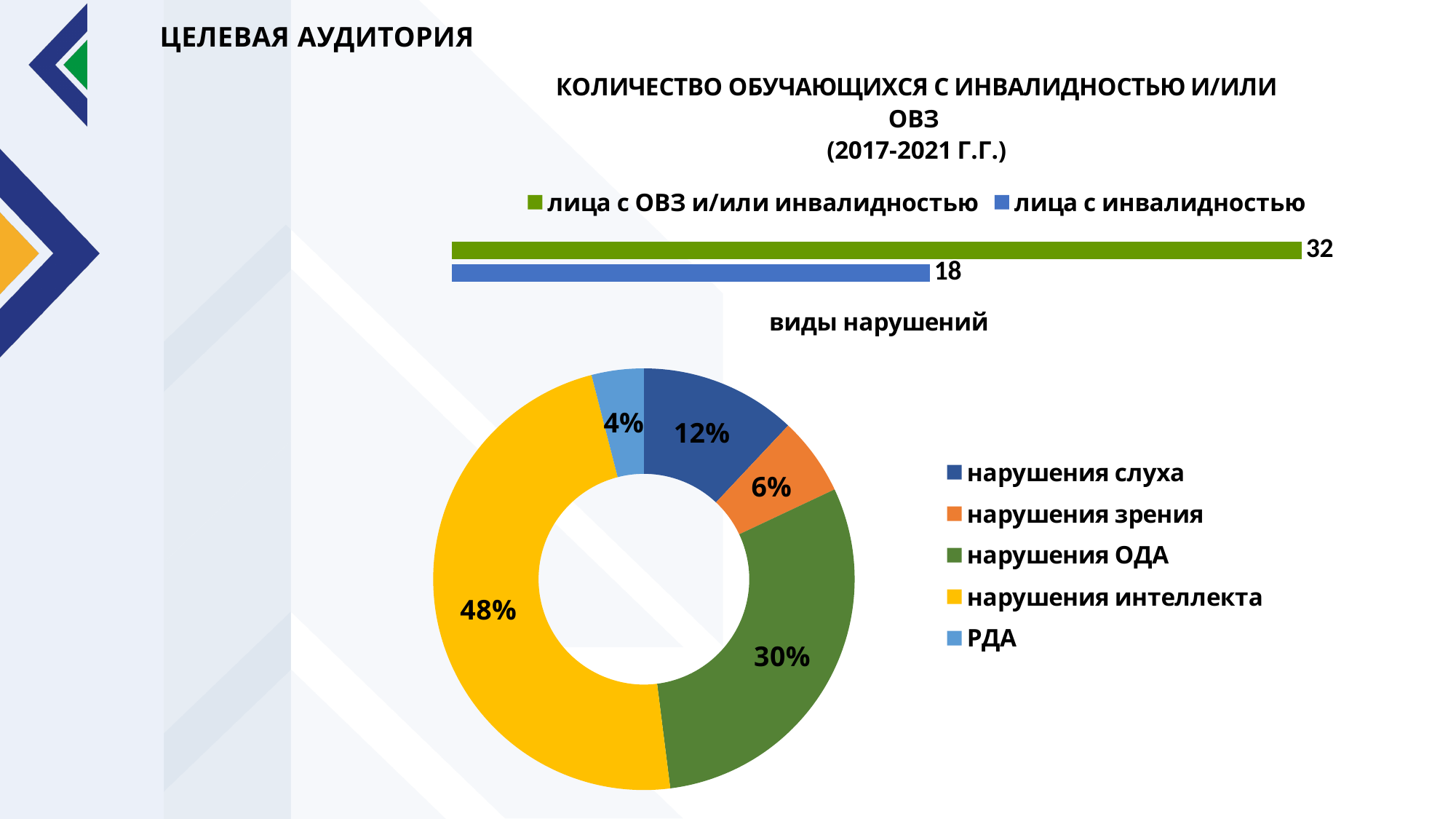
How many categories does the chart titled "виды нарушений" show? 5 In the chart titled "виды нарушений", what share is "нарушения ОДА"? 30% In the bar chart titled "КОЛИЧЕСТВО ОБУЧАЮЩИХСЯ С ИНВАЛИДНОСТЬЮ И/ИЛИ ОВЗ (2017-2021 Г.Г.)", what is the difference between the values for "лица с ОВЗ и/или инвалидностью" and "лица с инвалидностью"? 14 In the bar chart titled "КОЛИЧЕСТВО ОБУЧАЮЩИХСЯ С ИНВАЛИДНОСТЬЮ И/ИЛИ ОВЗ (2017-2021 Г.Г.)", which series has the larger value? лица с ОВЗ и/или инвалидностью In the chart titled "виды нарушений", which category has the largest share? нарушения интеллекта In the chart titled "виды нарушений", what share is "нарушения интеллекта"? 48% In the chart titled "виды нарушений", what share is "РДА"? 4% In the bar chart titled "КОЛИЧЕСТВО ОБУЧАЮЩИХСЯ С ИНВАЛИДНОСТЬЮ И/ИЛИ ОВЗ (2017-2021 Г.Г.)", what is the value for "лица с ОВЗ и/или инвалидностью"? 32 In the bar chart titled "КОЛИЧЕСТВО ОБУЧАЮЩИХСЯ С ИНВАЛИДНОСТЬЮ И/ИЛИ ОВЗ (2017-2021 Г.Г.)", what is the value for "лица с инвалидностью"? 18 How many series does the legend of the bar chart titled "КОЛИЧЕСТВО ОБУЧАЮЩИХСЯ С ИНВАЛИДНОСТЬЮ И/ИЛИ ОВЗ (2017-2021 Г.Г.)" list? 2 What kind of chart is the upper chart titled "КОЛИЧЕСТВО ОБУЧАЮЩИХСЯ С ИНВАЛИДНОСТЬЮ И/ИЛИ ОВЗ (2017-2021 Г.Г.)"? bar chart In the chart titled "виды нарушений", which category has the smallest share? РДА